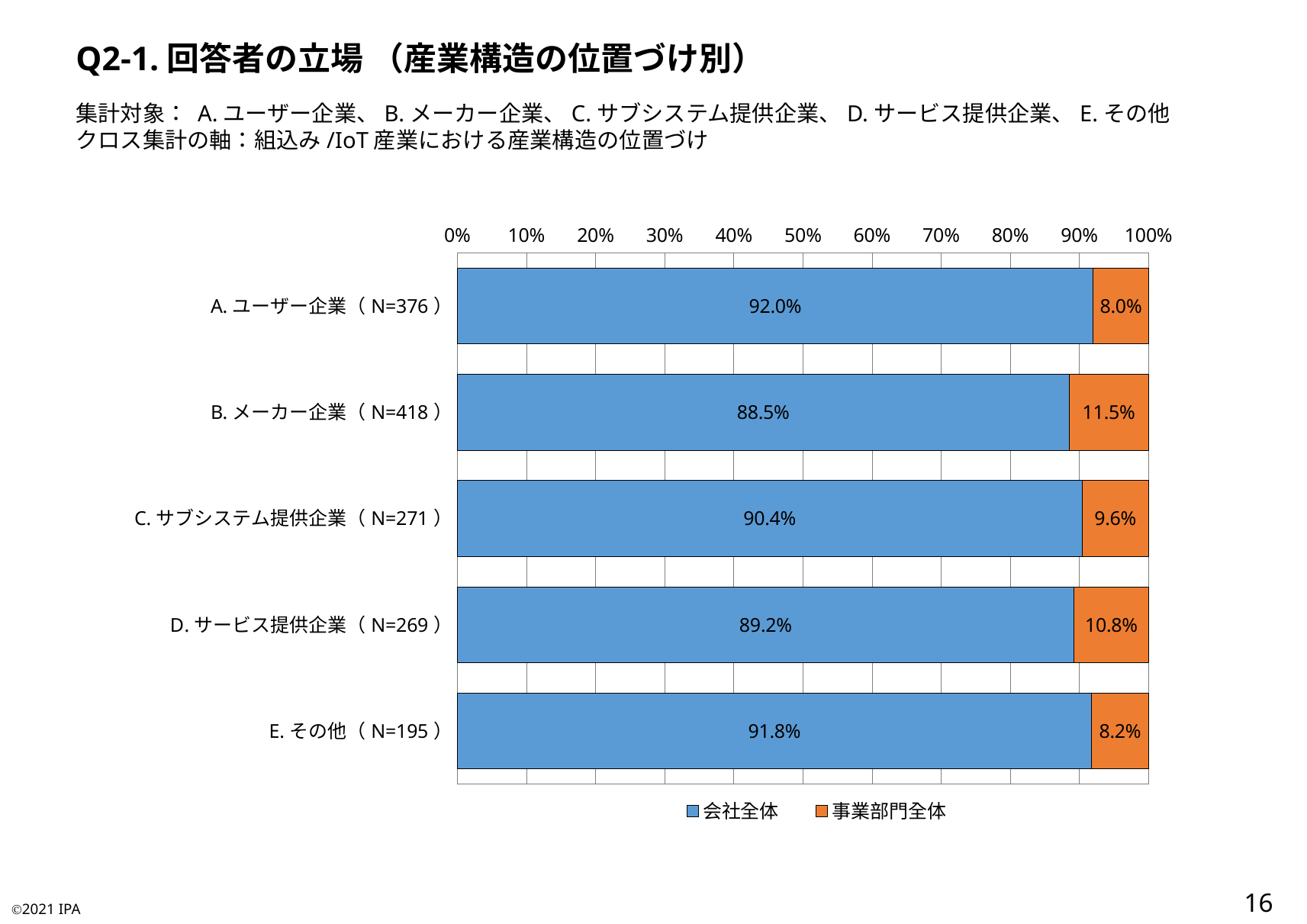
Which category has the lowest 会社全体 value? B. メーカー企業 How many series does the legend list? 2 What is the 事業部門全体 value for D. サービス提供企業? 10.8% What is the 会社全体 value for A. ユーザー企業? 92.0% What kind of chart is shown on the slide? Stacked bar chart How many categories are shown on the chart? 5 What is the sample size (N) shown for E. その他? 195 What is the 事業部門全体 value for B. メーカー企業? 11.5% What is the difference between the 会社全体 values for A. ユーザー企業 and B. メーカー企業? 3.5% Which category has the highest 会社全体 value? A. ユーザー企業 What is the 会社全体 value for C. サブシステム提供企業? 90.4% Which is larger, the 事業部門全体 value for C. サブシステム提供企業 or for E. その他? C. サブシステム提供企業